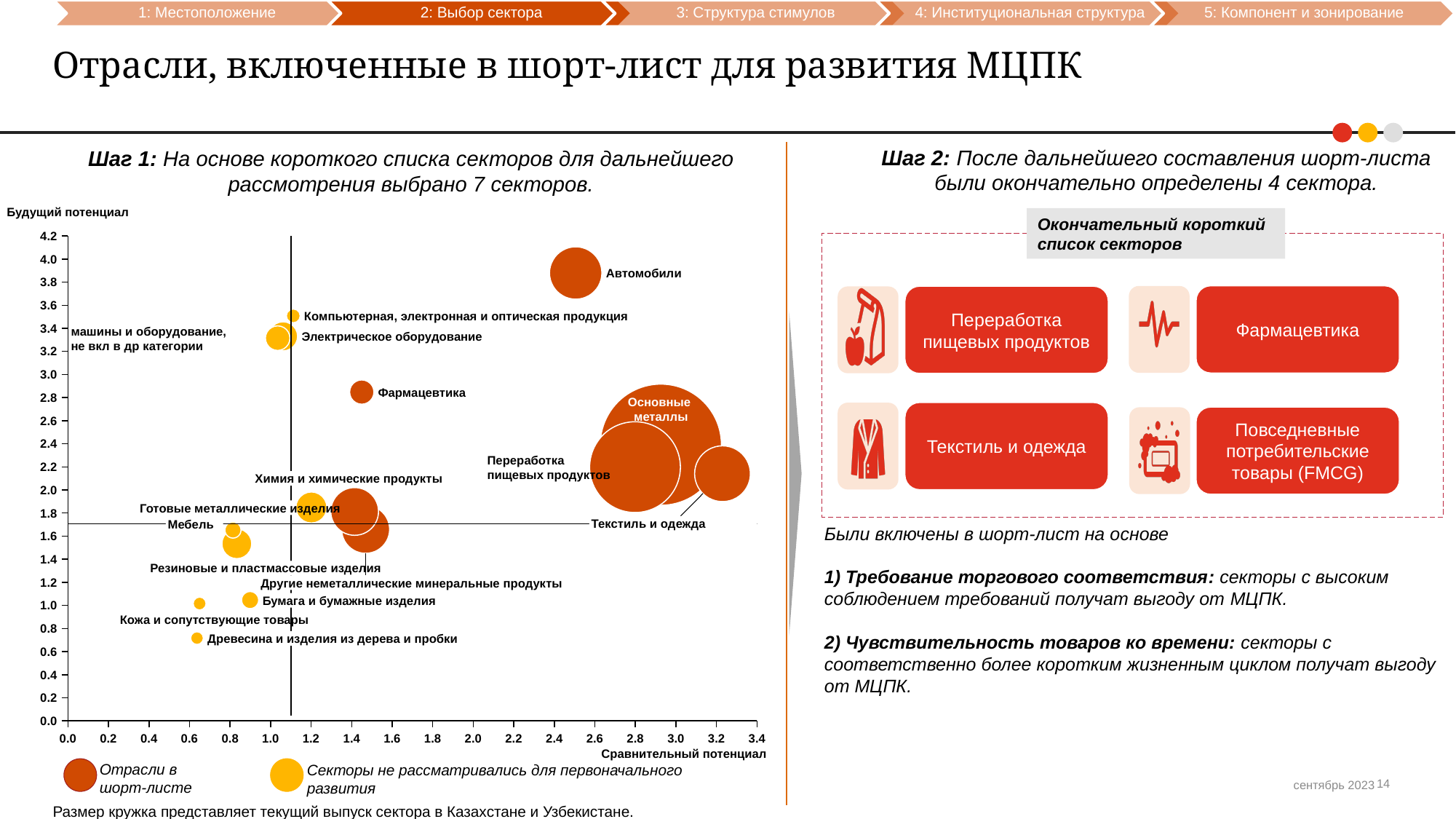
In the bubble chart, is the 'Сравнительный потенциал' value for Текстиль и одежда greater or less than 3.0? greater In the bubble chart, is the 'Будущий потенциал' value for Автомобили greater or less than 3.6? greater In the bubble chart, is the 'Сравнительный потенциал' value for Фармацевтика greater or less than 1.6? less How many entries does the legend of the bubble chart list? 2 What kind of chart is shown on the left side of the slide under 'Шаг 1'? Bubble chart In the bubble chart, which sector has the lowest value on the 'Будущий потенциал' (vertical) axis? Древесина и изделия из дерева и пробки According to the legend of the bubble chart, what do the yellow bubbles represent? Секторы не рассматривались для первоначального развития In the bubble chart, which sector has the higher 'Будущий потенциал': Автомобили or Фармацевтика? Автомобили In the bubble chart, which sector is positioned furthest to the right on the 'Сравнительный потенциал' axis? Текстиль и одежда In the bubble chart, which sector has the highest value on the 'Будущий потенциал' (vertical) axis? Автомобили